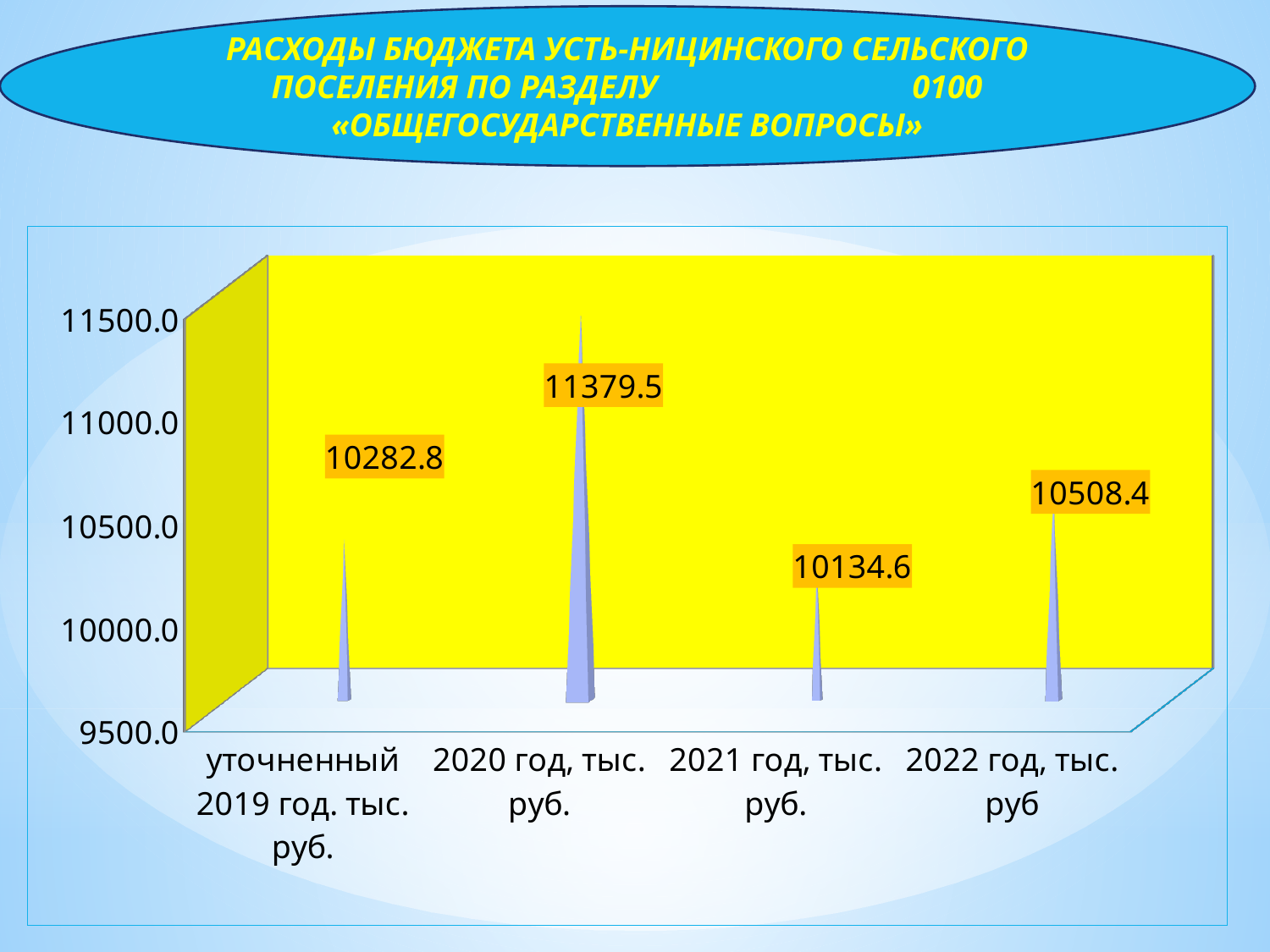
What is the value for 2020 год, тыс. руб.? 11379.5 What is the difference between the values for 2020 год and 2021 год? 1244.9 Which category has the lowest value? 2021 год, тыс. руб. What is the difference between the values for 2022 год and уточненный 2019 год? 225.6 What kind of chart is shown on the slide? bar chart Is the value for 2020 год, тыс. руб. greater or less than 11000.0? greater What is the value for 2022 год, тыс. руб? 10508.4 Which category has the highest value? 2020 год, тыс. руб. Which is larger, the value for 2022 год or the value for уточненный 2019 год? 2022 год, тыс. руб What is the value for 2021 год, тыс. руб.? 10134.6 What is the value for уточненный 2019 год. тыс. руб.? 10282.8 How many categories are shown on the x axis? 4